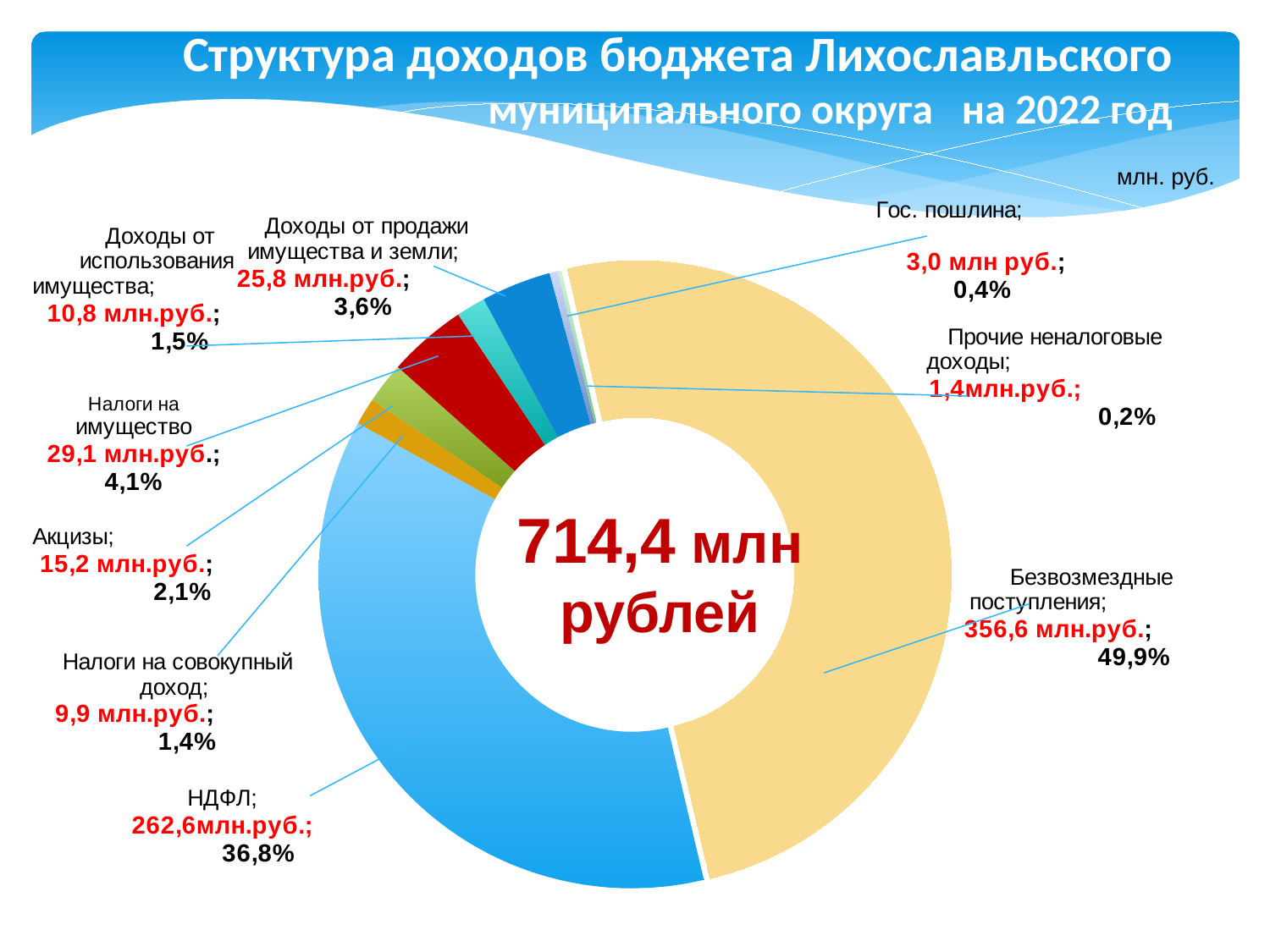
What is the difference in value between Безвозмездные поступления and НДФЛ? 94,0 млн.руб. How many categories are shown in the chart? 9 What is the value for Налоги на имущество? 29,1 млн.руб. What type of chart is shown on the slide? Pie (donut) chart Which category has the smallest share of the chart? Прочие неналоговые доходы Which is larger: Акцизы or Налоги на совокупный доход? Акцизы What share of the chart does НДФЛ represent? 36,8% Which category has the largest share of the chart? Безвозмездные поступления What is the total value shown in the centre of the chart? 714,4 млн рублей What is the value for Доходы от продажи имущества и земли? 25,8 млн.руб. What share of the chart does Гос. пошлина represent? 0,4% What is the value for Безвозмездные поступления? 356,6 млн.руб.